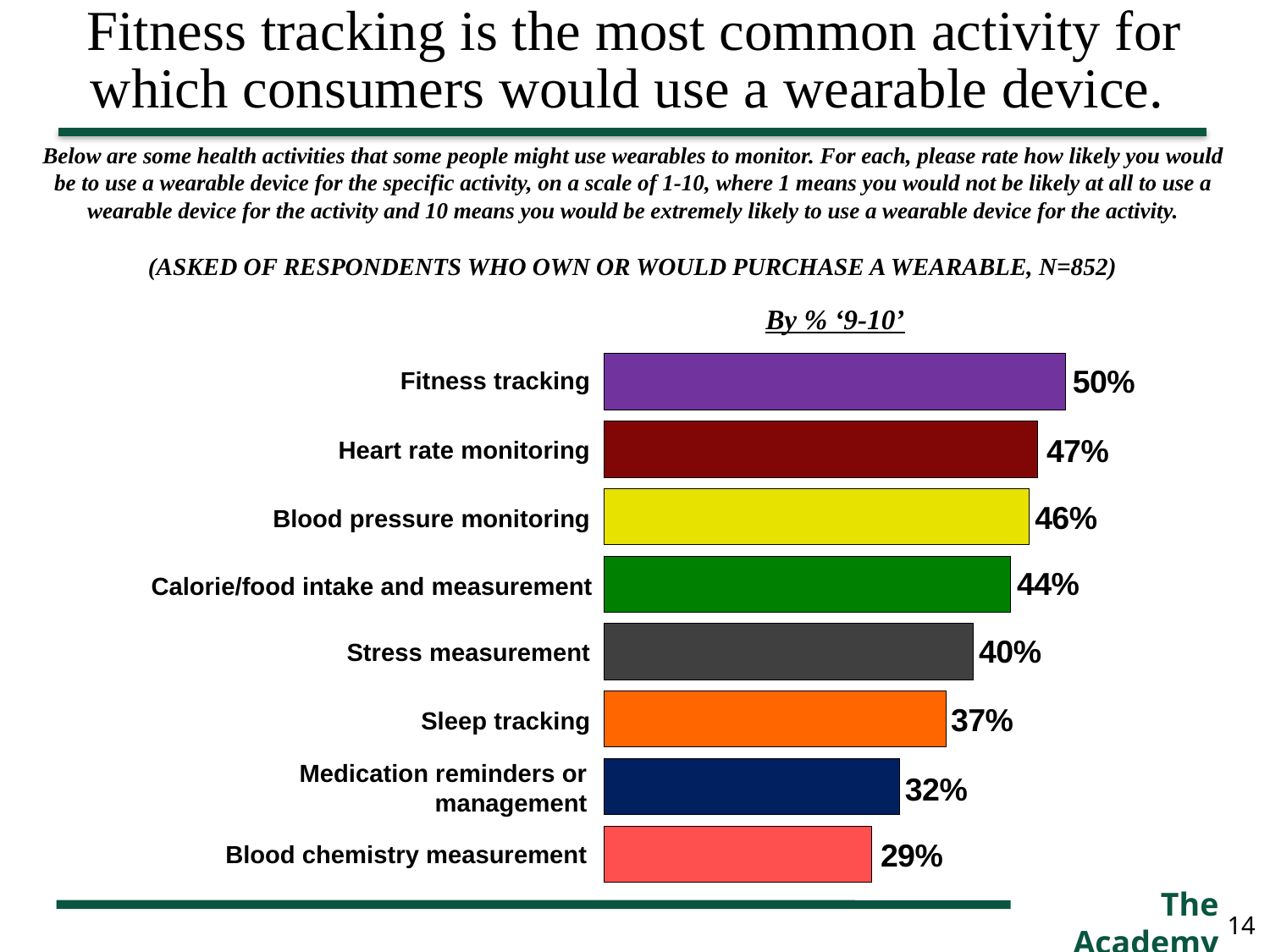
What is the difference between the values for Heart rate monitoring and Stress measurement? 7% What is the title shown above the chart? By % '9-10' What is the value shown for Sleep tracking? 37% What kind of chart is shown on the slide? Bar chart How many activities are shown in the chart? 8 What is the difference between the values for Fitness tracking and Blood chemistry measurement? 21% What is the value shown for Medication reminders or management? 32% Which activity has the lowest percentage? Blood chemistry measurement What percentage of respondents rated Fitness tracking '9-10'? 50% Which has a larger value, Stress measurement or Medication reminders or management? Stress measurement Which activity has the highest percentage? Fitness tracking Which has a larger value, Calorie/food intake and measurement or Sleep tracking? Calorie/food intake and measurement